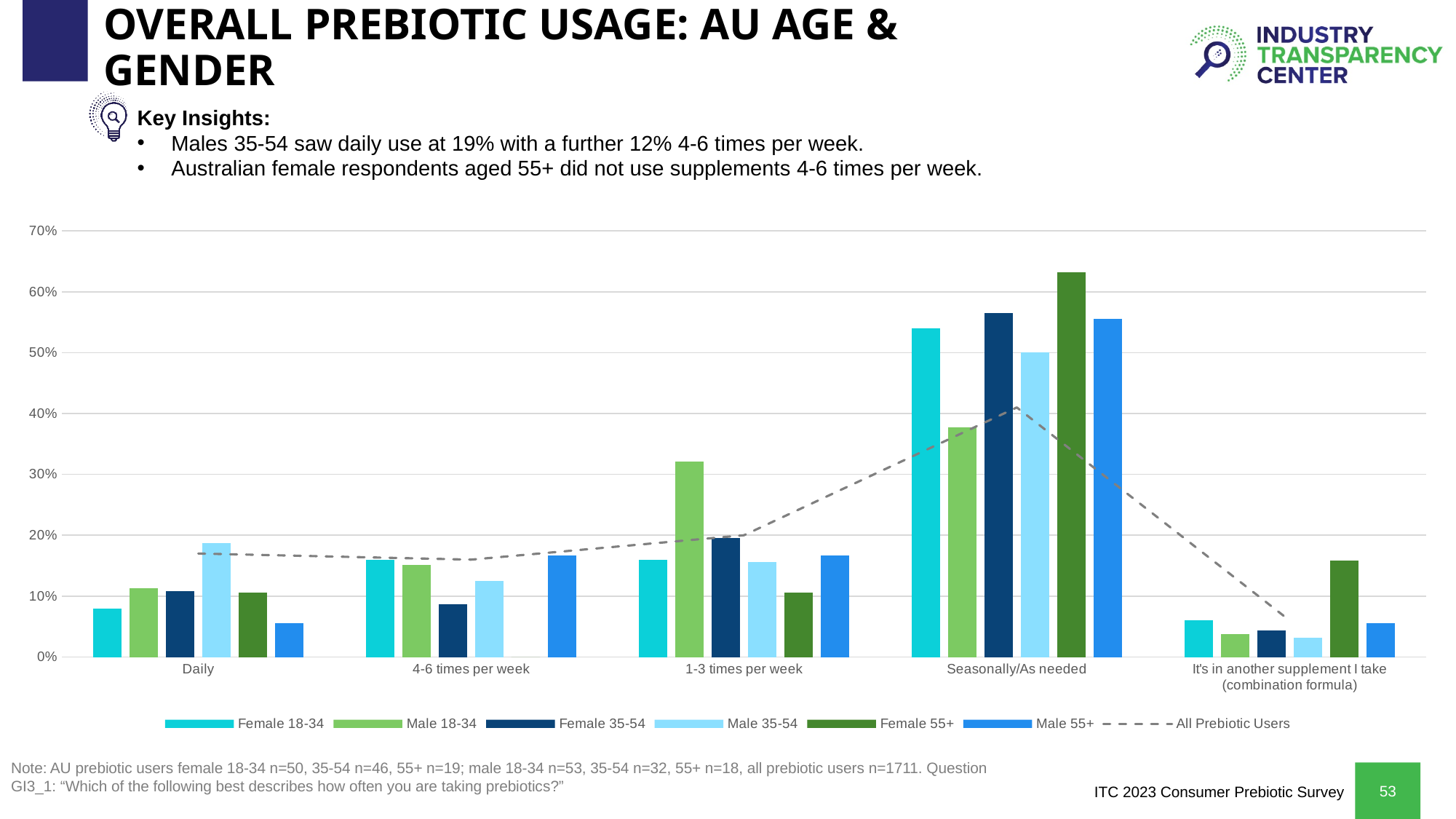
Is the value for Male 18-34 in the 1-3 times per week category greater or less than 30%? greater Is the value for Male 55+ in the Daily category greater or less than 10%? less Does the All Prebiotic Users dashed line rise or fall from Seasonally/As needed to It's in another supplement I take (combination formula)? Fall In the Seasonally/As needed category, which is larger: Female 35-54 or Male 35-54? Female 35-54 How many frequency categories are shown along the x axis? 5 How many series does the legend list? 7 Is the value for Female 55+ in the Seasonally/As needed category greater or less than 60%? greater Which series is drawn as a dashed line rather than bars? All Prebiotic Users Which series has the highest bar in the Seasonally/As needed category? Female 55+ Which series has the lowest bar in the Daily category? Male 55+ Which series has the highest bar in the Daily category? Male 35-54 What kind of chart is shown on the slide? Bar chart (with a dashed line series)